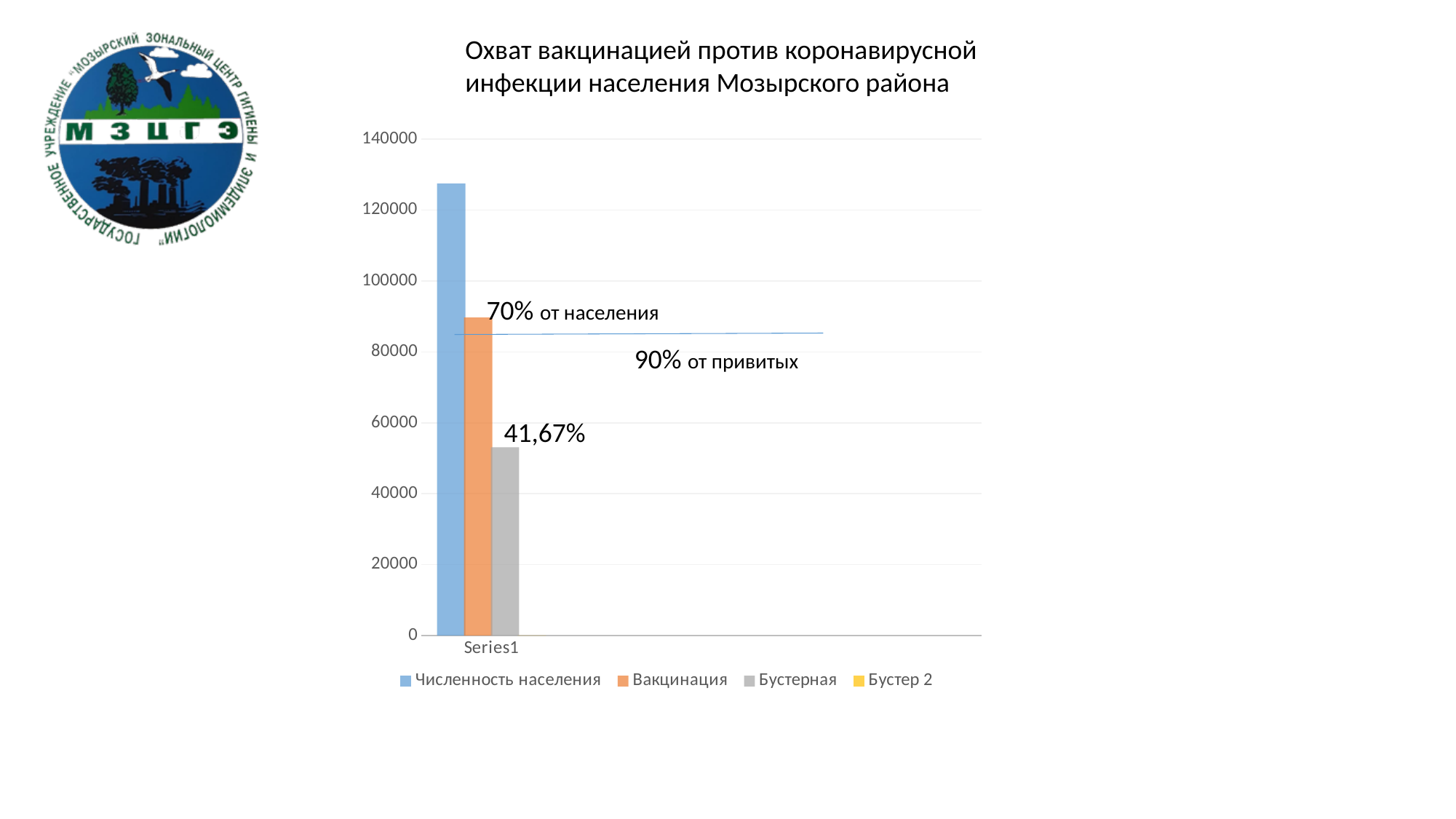
Which series has the tallest bar? Численность населения Is the value for Вакцинация greater or less than 100000? less Which is larger, the bar for Вакцинация or the bar for Бустерная? Вакцинация Is the value for Вакцинация greater or less than 80000? greater How many series does the legend list? 4 What colour is the bar for Вакцинация? orange Is the value for Бустерная greater or less than 60000? less Which of the three visible bars is the shortest? Бустерная According to the annotation on the chart, what percentage of the population is covered by vaccination? 70% What kind of chart is shown on the slide? bar chart What percentage label is printed next to the gray Бустерная bar? 41,67%